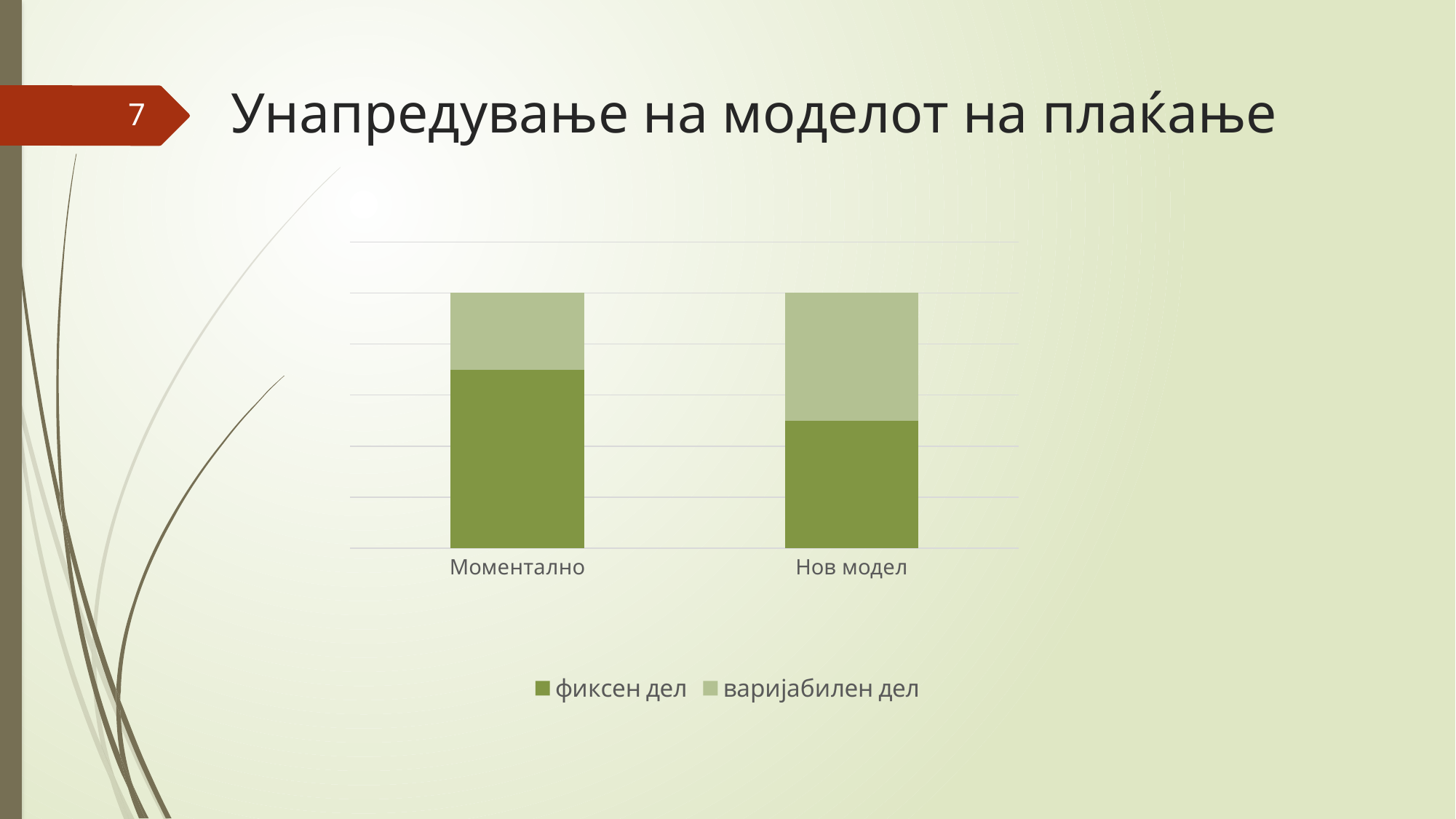
Which series is shown in the darker green colour? фиксен дел What are the two categories shown on the x axis? Моментално and Нов модел How many categories are shown on the x axis of the chart? 2 Which category has the larger варијабилен дел segment, Моментално or Нов модел? Нов модел Does the варијабилен дел segment rise or fall from Моментално to Нов модел? rise How many series does the chart legend list? 2 What kind of chart is shown on the slide? stacked bar chart Does the фиксен дел segment rise or fall from Моментално to Нов модел? fall In which category is the варијабилен дел segment the largest? Нов модел Which category has the larger фиксен дел segment, Моментално or Нов модел? Моментално In which category is the фиксен дел segment the smallest? Нов модел Are the total heights of the two stacked bars the same or different? the same